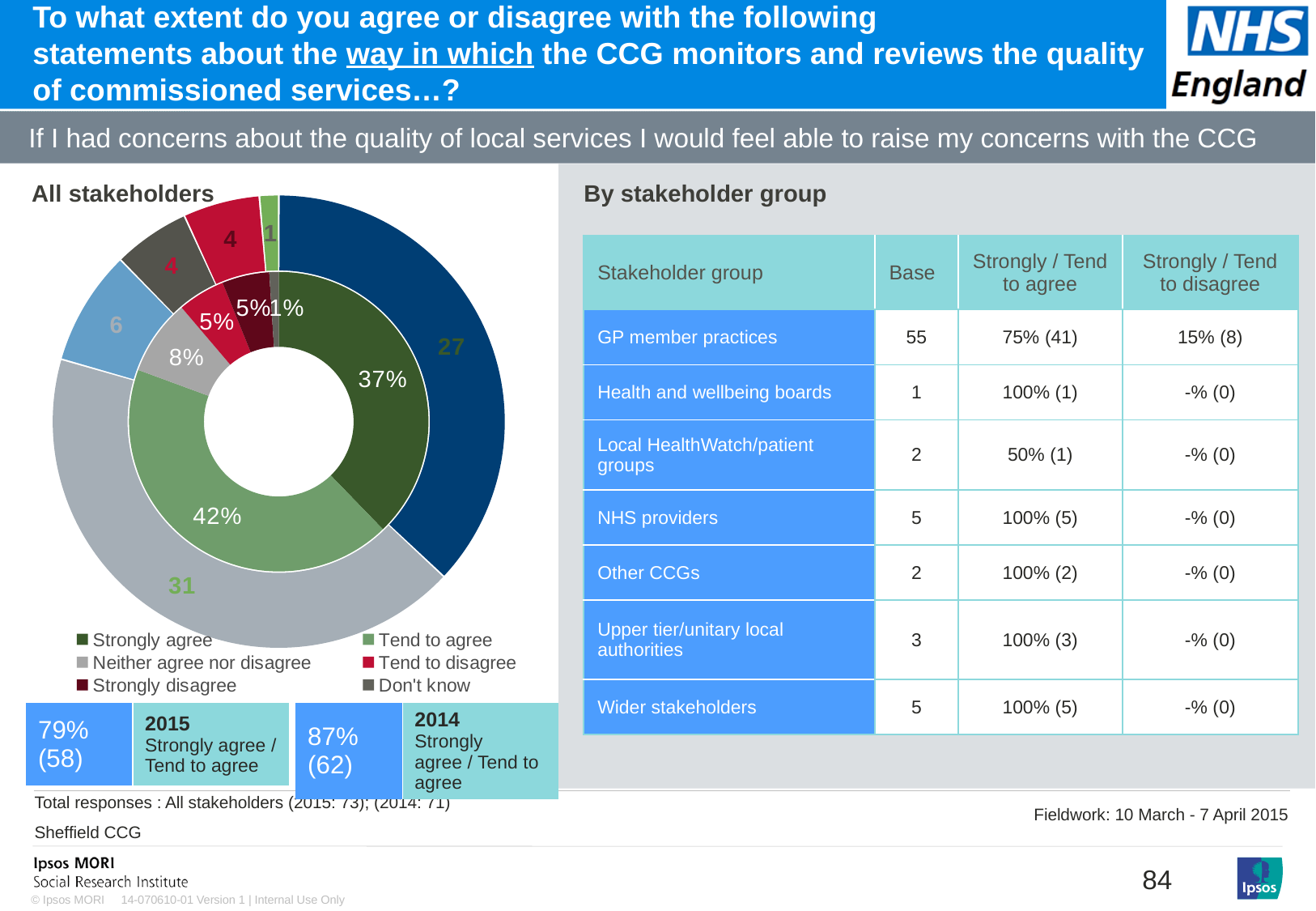
How many response categories does the legend of the 'All stakeholders' chart list? 6 What kind of chart is shown under the heading 'All stakeholders'? doughnut chart In the 'All stakeholders' chart, which response category has the smallest share? Don't know In the 'All stakeholders' chart, what percentage of respondents strongly agree? 37% In the 'All stakeholders' chart, which is larger: the share for 'Strongly agree' or for 'Neither agree nor disagree'? Strongly agree In the 'All stakeholders' chart, how many percentage points higher is 'Tend to agree' than 'Strongly agree'? 5 In the 'All stakeholders' chart, what percentage neither agree nor disagree? 8% In the 'All stakeholders' chart, what percentage answered 'Don't know'? 1% In the 'All stakeholders' chart, what number is shown on the outer ring for 'Strongly agree'? 27 In the 'All stakeholders' chart, which response category has the largest share? Tend to agree In the 'All stakeholders' chart, what number is shown on the outer ring for 'Tend to agree'? 31 In the 'All stakeholders' chart, what percentage of respondents tend to agree? 42%